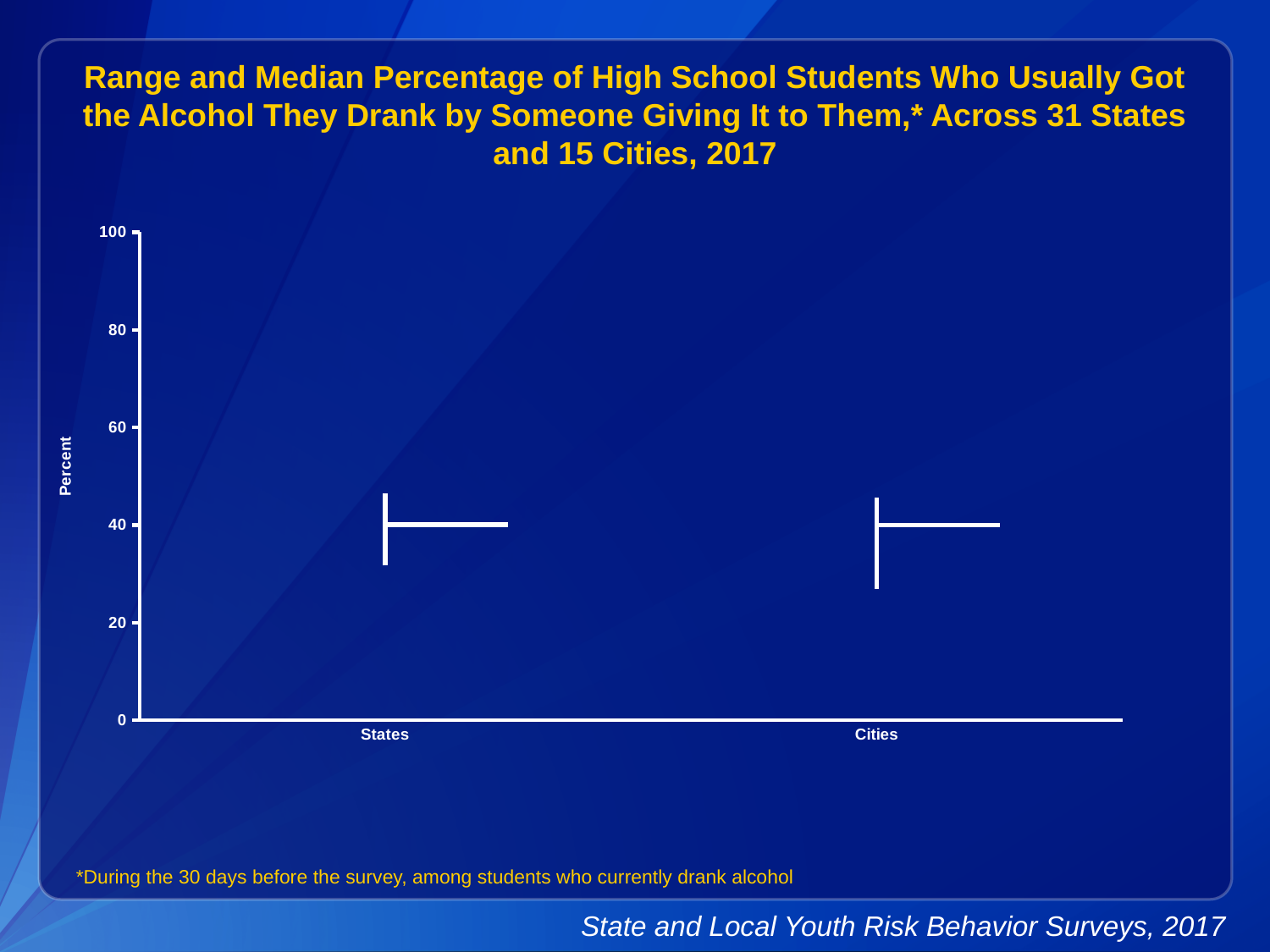
What are the two categories shown on the x axis? States and Cities Which category has the lower bottom end of its range, States or Cities? Cities What is the label on the y axis of the chart? Percent Is the median value for Cities greater or less than 20? greater What is the highest tick value shown on the y axis? 100 Is the lower end of the range for States greater or less than 20? greater How many categories are shown on the x axis of the chart? 2 Is the upper end of the range for Cities greater or less than 60? less